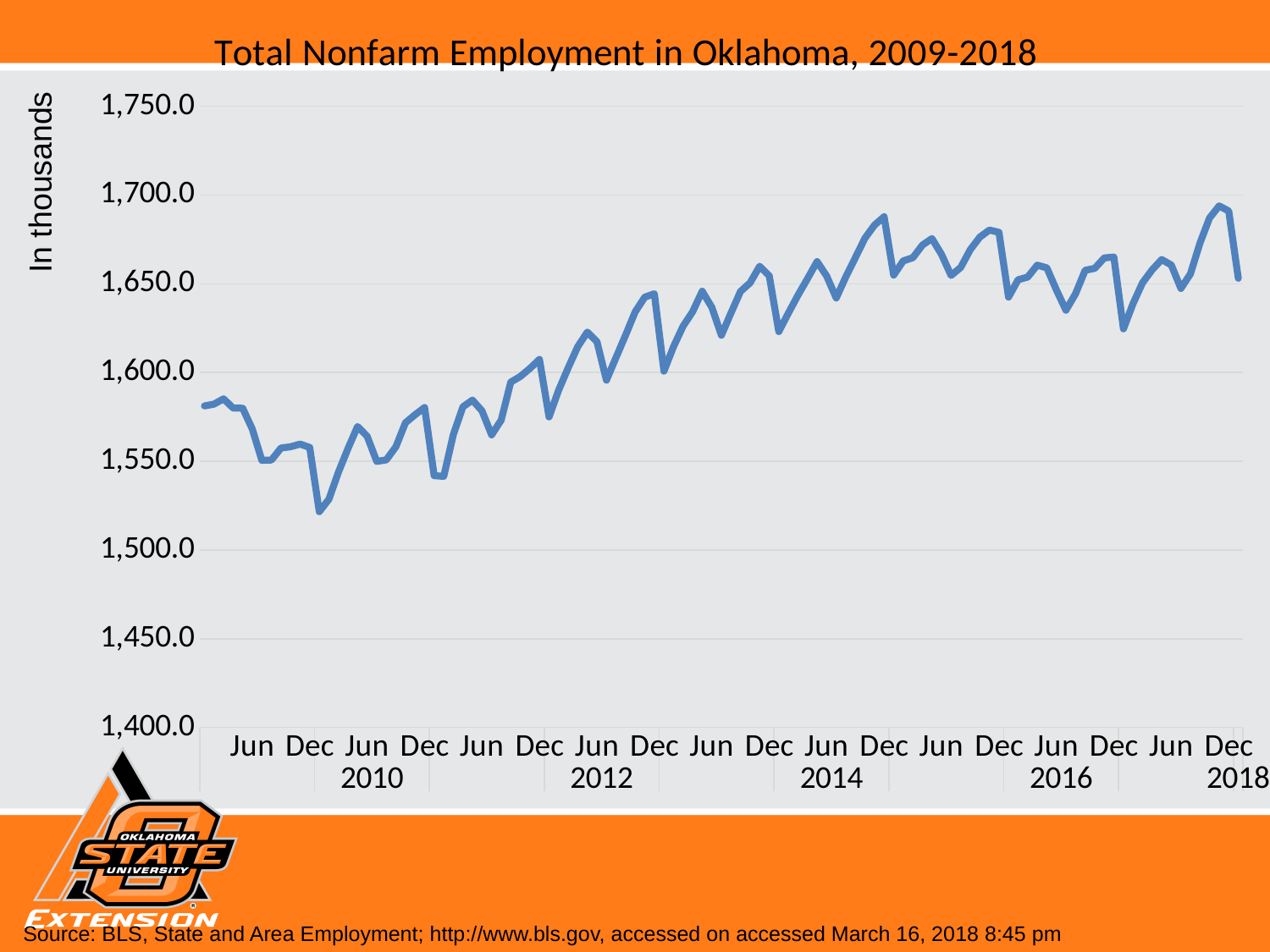
Overall, does total nonfarm employment in Oklahoma rise or fall from 2009 to 2018? rise Is the value at the start of the line (Jun 2009) greater or less than 1,600.0? less What kind of chart is shown on the slide? line chart What unit label is shown on the vertical axis of the chart? In thousands What is the title of the chart? Total Nonfarm Employment in Oklahoma, 2009-2018 Is the value at Dec 2014 greater or less than 1,650.0? greater Is the highest point of the line near the beginning or the end of the period shown? end Which is larger, the value at Dec 2010 or the value at Dec 2014? Dec 2014 How many data series are plotted on the chart? 1 Is the lowest point of the line near the beginning or the end of the period shown? beginning